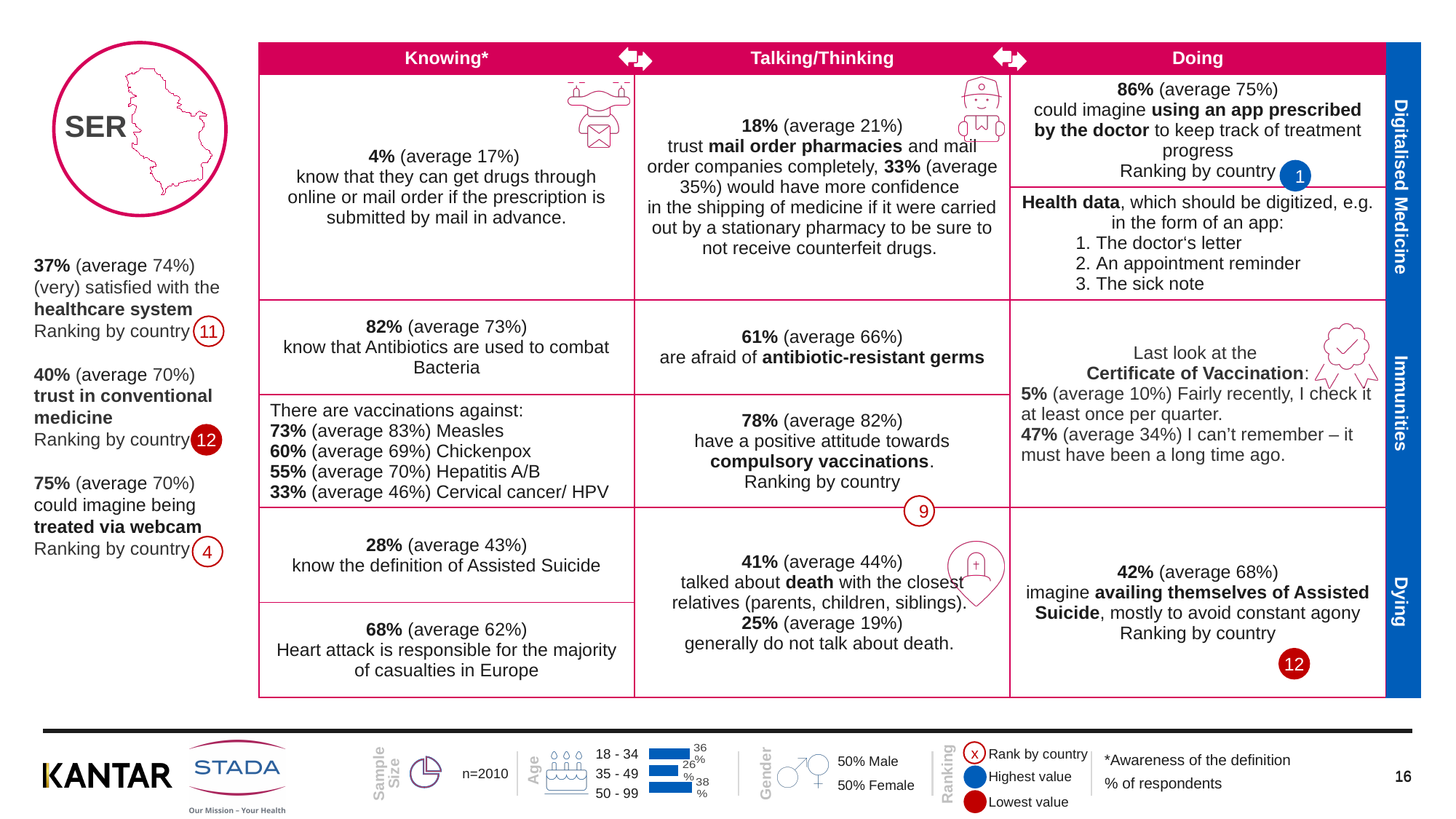
What is the sample size shown next to the Age bar chart at the bottom of the slide? n=2010 In the Age bar chart at the bottom of the slide, what do the three age group percentages add up to? 100% Are the bars in the Age chart at the bottom of the slide horizontal or vertical? Horizontal In the Age bar chart at the bottom of the slide, which age group has the largest share of respondents? 50 - 99 In the Age bar chart at the bottom of the slide, what percentage of respondents are aged 18 - 34? 36% In the Age bar chart at the bottom of the slide, which group is larger: 18 - 34 or 50 - 99? 50 - 99 In the Age bar chart at the bottom of the slide, what percentage of respondents are aged 35 - 49? 26% In the Age bar chart at the bottom of the slide, what is the difference in percentage points between the 50 - 99 group and the 35 - 49 group? 12 percentage points How many age groups are shown in the Age bar chart at the bottom of the slide? 3 What kind of chart is used to show the age distribution at the bottom of the slide? Bar chart In the Age bar chart at the bottom of the slide, what percentage of respondents are aged 50 - 99? 38% In the Age bar chart at the bottom of the slide, which age group has the smallest share of respondents? 35 - 49